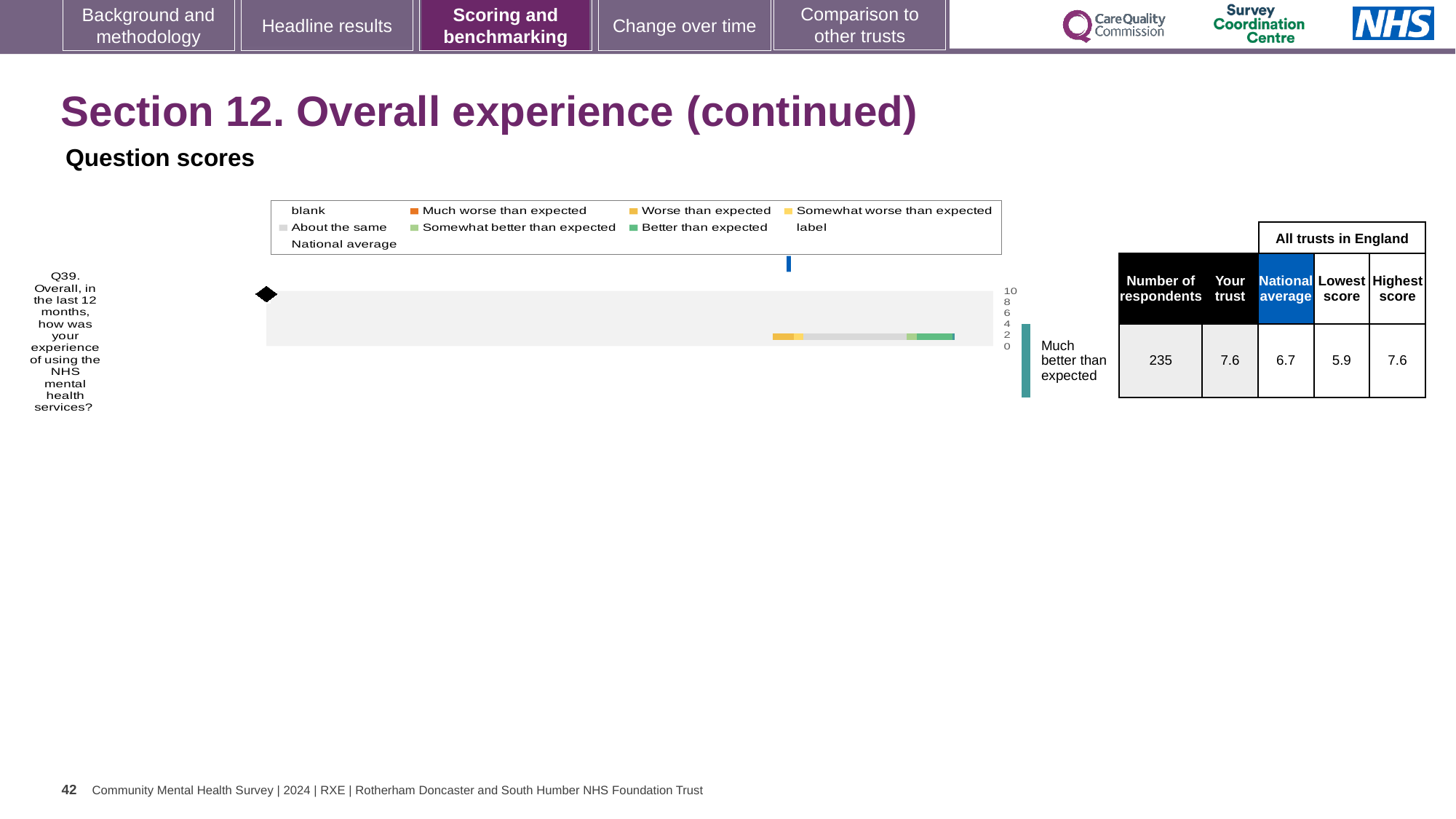
What is the highest score among all trusts in England for Q39? 7.6 What is the national average score for Q39? 6.7 What kind of chart is used to show the Q39 question score? bar chart What label appears at the right-hand end of the Q39 scale? Much better than expected What is the difference between the 'Your trust' score and the national average for Q39? 0.9 What is the lowest score among all trusts in England for Q39? 5.9 How many respondents answered Q39? 235 What is the difference between the highest and lowest scores for Q39 across all trusts in England? 1.7 How many questions are plotted in the chart? 1 What is the 'Your trust' score for Q39 shown in the table next to the chart? 7.6 What colour represents 'Much worse than expected' in the chart legend? orange Which is higher for Q39: the 'Your trust' score or the national average? Your trust